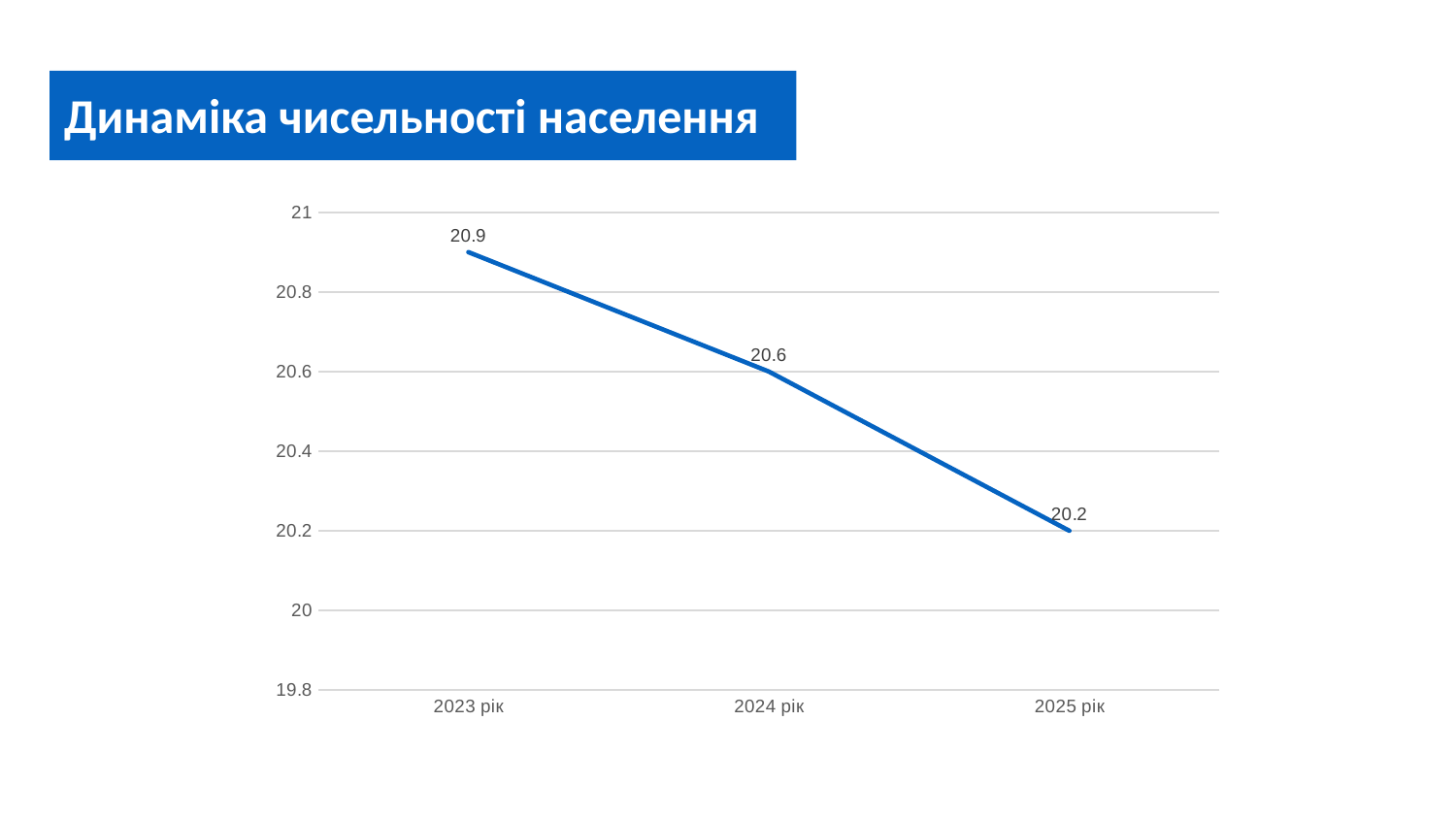
What is the value for 2025 рік? 20.2 What is the difference between the values for 2023 рік and 2025 рік? 0.7 How many data points are plotted on the chart? 3 What is the difference between the values for 2023 рік and 2024 рік? 0.3 What is the value for 2024 рік? 20.6 Is the value for 2025 рік greater or less than 20.4? less What kind of chart is shown on the slide? line chart What is the value for 2023 рік? 20.9 Which year has the lowest value? 2025 рік Which is larger, the value for 2024 рік or the value for 2025 рік? 2024 рік Which year has the highest value? 2023 рік Do the values rise or fall from 2023 рік to 2025 рік? fall